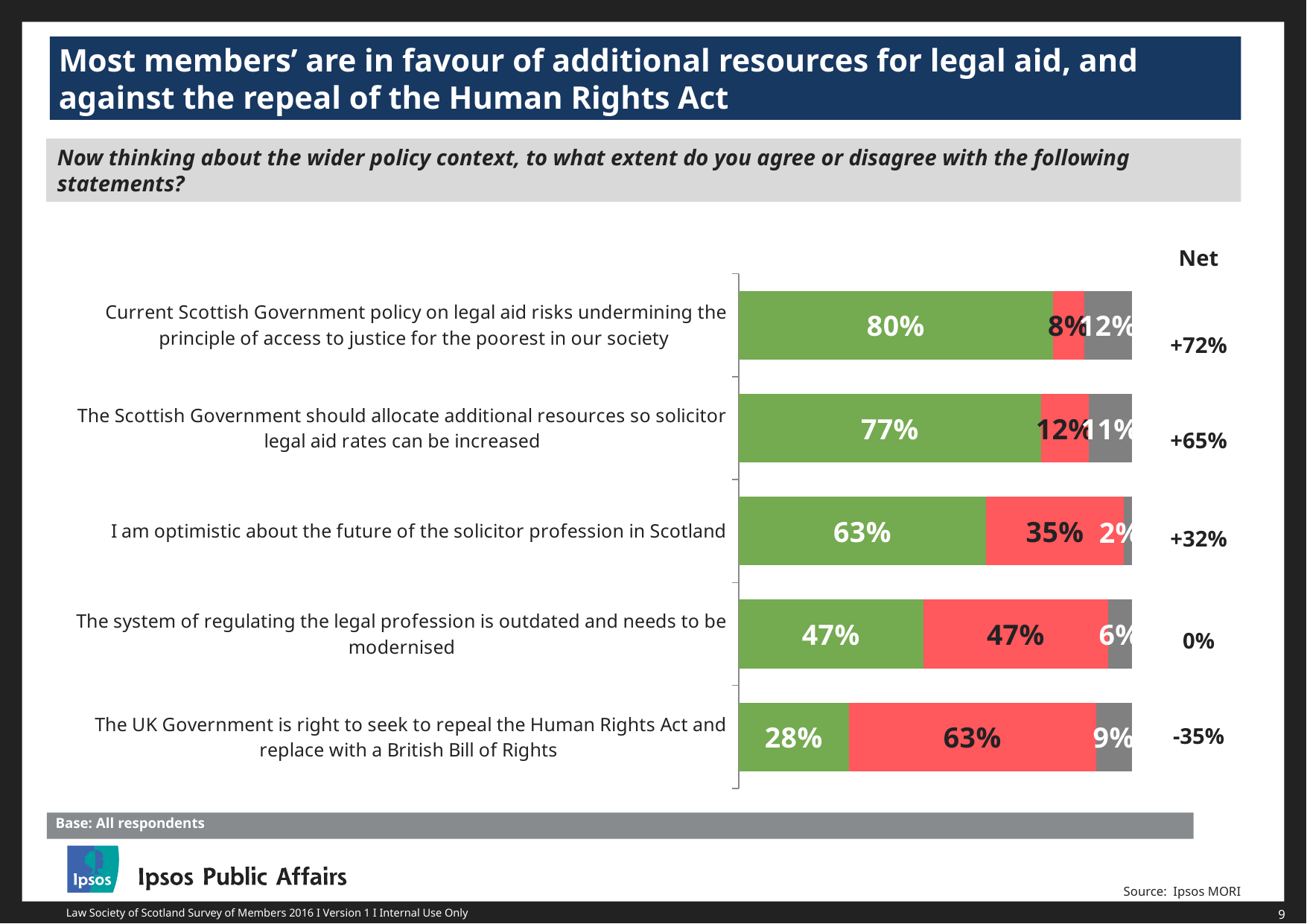
What is the Net figure shown for "The UK Government is right to seek to repeal the Human Rights Act and replace with a British Bill of Rights"? -35% What is the value of the grey segment for "Current Scottish Government policy on legal aid risks undermining the principle of access to justice for the poorest in our society"? 12% What is the total of the three segments in the bar for "The Scottish Government should allocate additional resources so solicitor legal aid rates can be increased"? 100% For "I am optimistic about the future of the solicitor profession in Scotland", how much larger is the green segment than the red segment? 28 percentage points What is the Net figure shown for "The system of regulating the legal profession is outdated and needs to be modernised"? 0% What kind of chart is shown on the slide? Stacked bar chart Which has a larger green segment: "The Scottish Government should allocate additional resources so solicitor legal aid rates can be increased" or "I am optimistic about the future of the solicitor profession in Scotland"? The Scottish Government should allocate additional resources so solicitor legal aid rates can be increased How many statements are plotted in the chart? 5 What is the value of the red segment for "The UK Government is right to seek to repeal the Human Rights Act and replace with a British Bill of Rights"? 63% Which statement has the largest green segment? Current Scottish Government policy on legal aid risks undermining the principle of access to justice for the poorest in our society Which statement has the smallest green segment? The UK Government is right to seek to repeal the Human Rights Act and replace with a British Bill of Rights What is the value of the green segment for "I am optimistic about the future of the solicitor profession in Scotland"? 63%